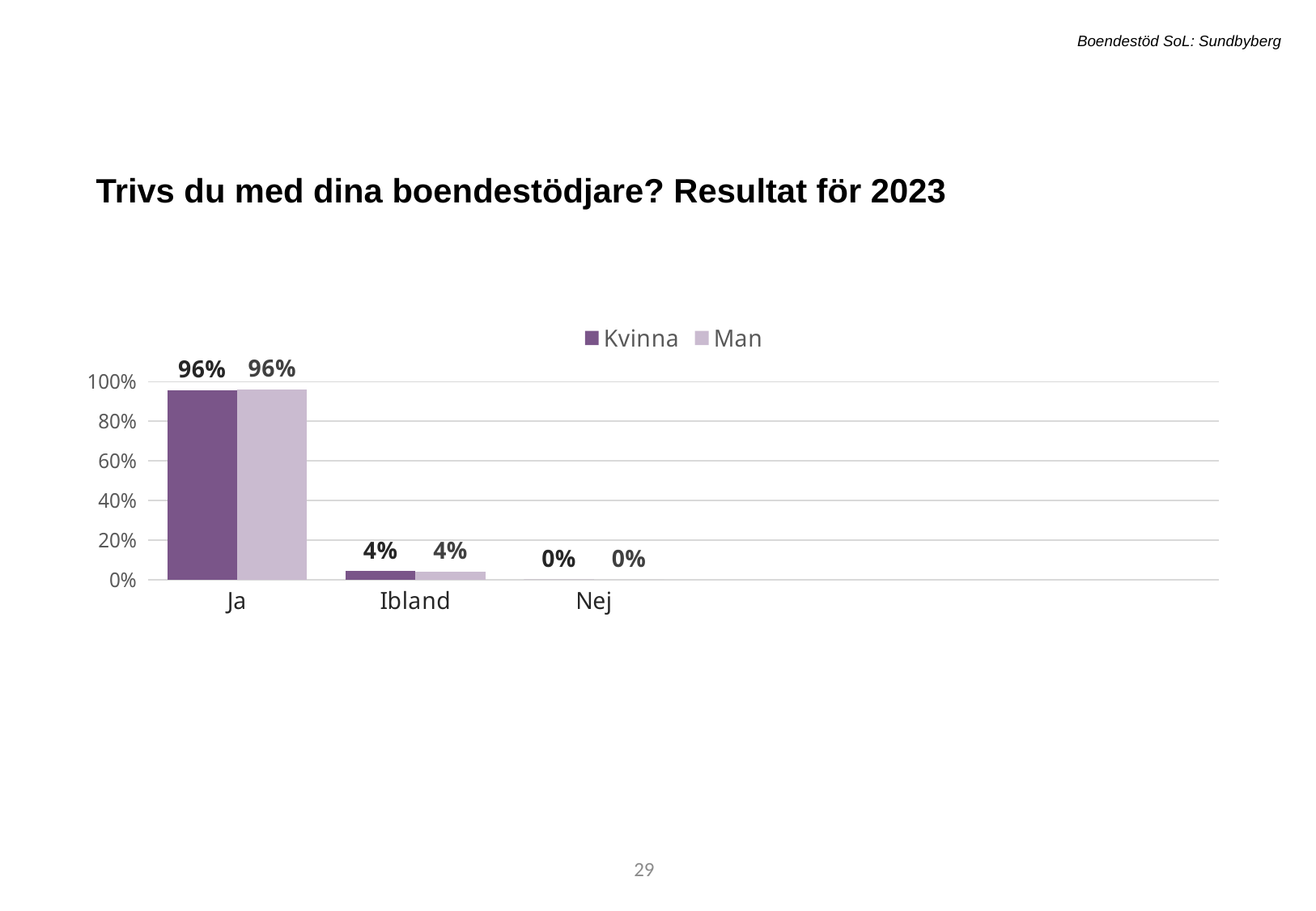
How many series does the legend list? 2 Which is larger: the Kvinna value for Ibland or the Kvinna value for Nej? Ibland Is the value for Man in the Ja category greater or less than 80%? greater What is the value for Kvinna in the Ja category? 96% What is the difference between the Kvinna values for Ja and Ibland? 92% What kind of chart is shown on the slide? bar chart What are the two series named in the legend? Kvinna and Man Which category has the lowest value for the Kvinna series? Nej What is the value for Man in the Ibland category? 4% What is the value for Kvinna in the Nej category? 0% How many categories are shown on the x axis? 3 Which category has the highest value for the Man series? Ja